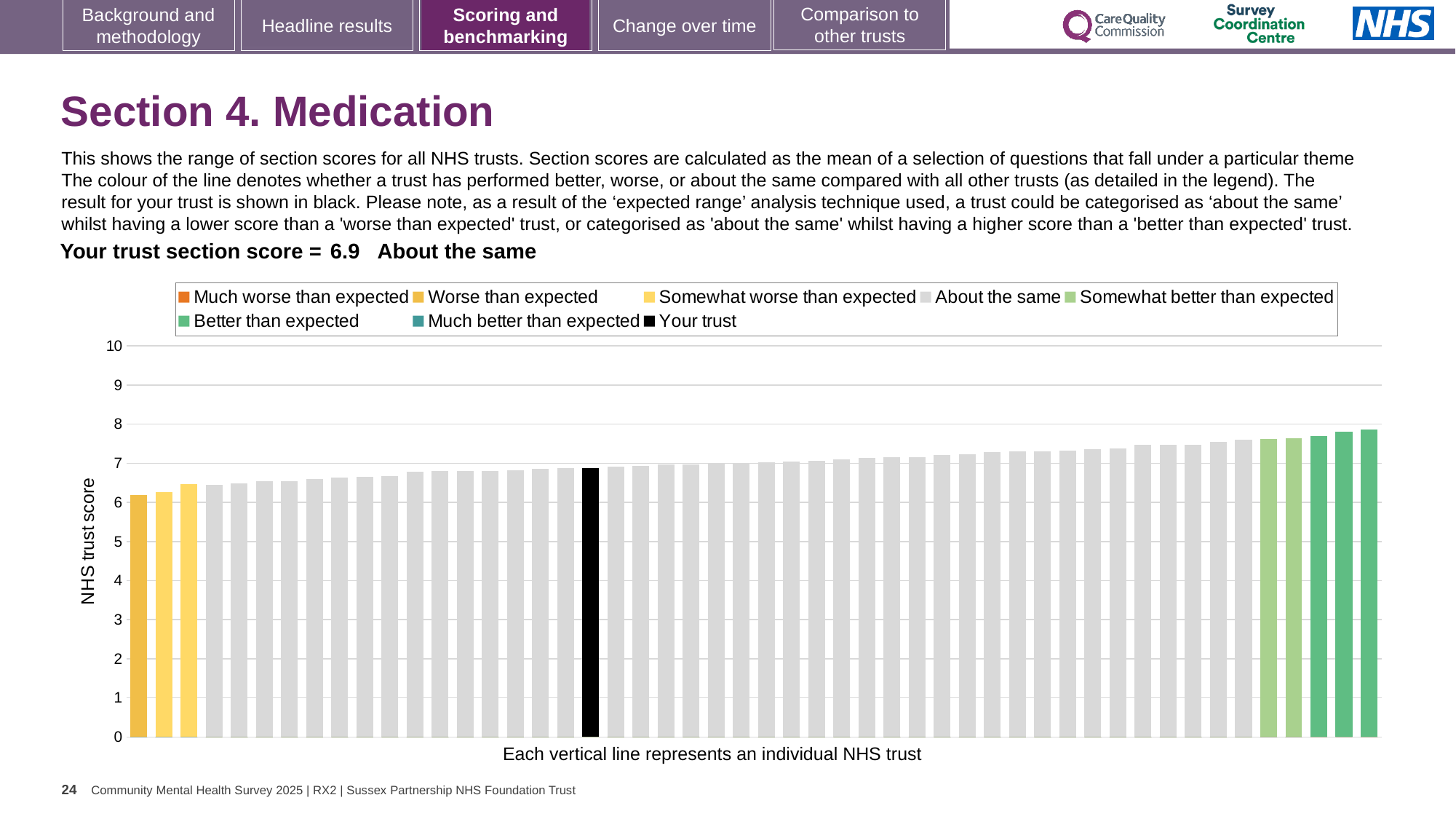
What colour is used for the bar representing your trust? black Is your trust's bar higher or lower than the leftmost bar? higher What kind of chart is shown on the slide? bar chart Do the bar values rise or fall from left to right across the chart? rise Which performance category is your trust placed in for the Medication section? About the same Is the value of the leftmost bar greater or less than 6? greater What is your trust's section score for Medication? 6.9 Is the value of the black bar (your trust) greater or less than 5? greater Is the value of the rightmost bar greater or less than 8? less How many entries does the chart legend list? 8 What is the label on the vertical axis of the chart? NHS trust score